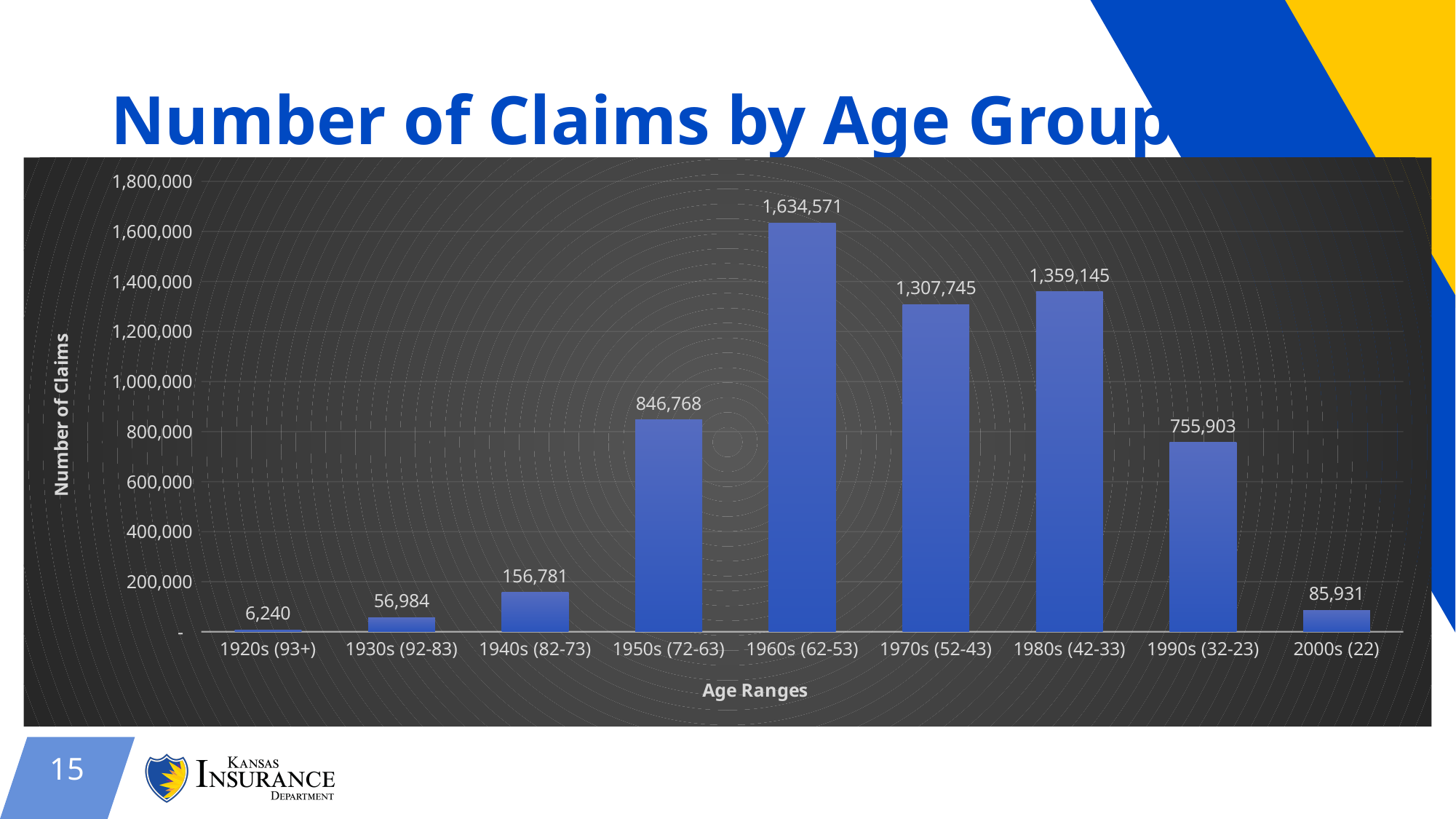
What is the number of claims for the 1990s (32-23) age group? 755,903 Which age group has the lowest number of claims? 1920s (93+) What type of chart is shown on the slide? bar chart What is the number of claims for the 1920s (93+) age group? 6,240 Is the number of claims for the 1940s (82-73) group greater or less than 200,000? less What is the difference in claims between the 1980s (42-33) and 1970s (52-43) age groups? 51,400 Which has more claims, the 1950s (72-63) group or the 1990s (32-23) group? 1950s (72-63) What is the number of claims for the 1960s (62-53) age group? 1,634,571 Which age group has the highest number of claims? 1960s (62-53) How many age groups are shown on the chart? 9 What is the label of the vertical axis? Number of Claims What is the label of the horizontal axis? Age Ranges